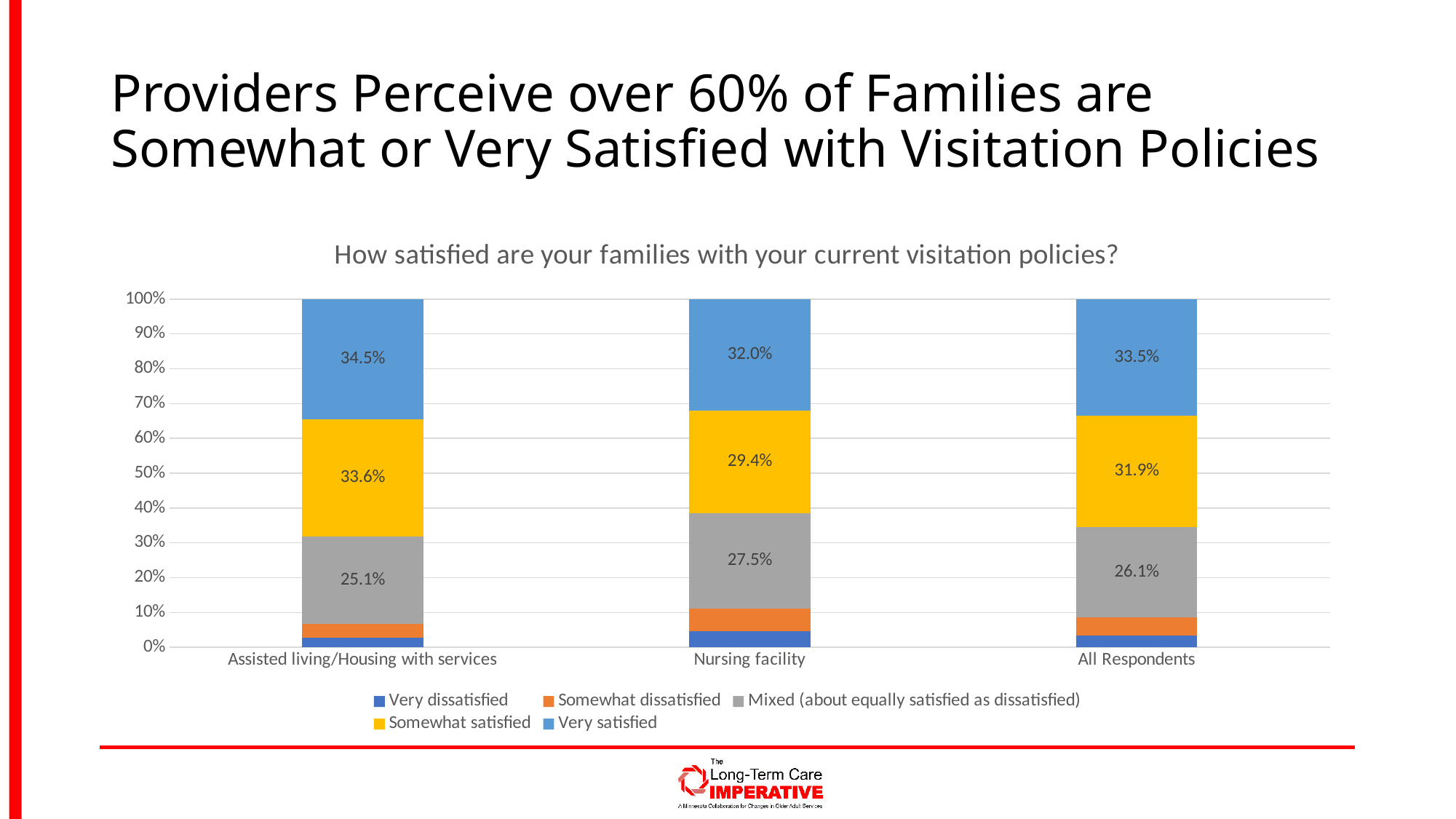
What kind of chart is shown on the slide? Stacked bar chart Which is larger: the Mixed value for Nursing facility or the Mixed value for All Respondents? Nursing facility What is the Mixed (about equally satisfied as dissatisfied) value for All Respondents? 26.1% What percentage of families are perceived as Very satisfied for Assisted living/Housing with services? 34.5% Is the Very dissatisfied value for Nursing facility greater or less than 10%? less How many series does the legend list? 5 Which category has the lowest Somewhat satisfied percentage? Nursing facility What is the Somewhat satisfied value for Nursing facility? 29.4% What is the difference between the Very satisfied values for Assisted living/Housing with services and Nursing facility? 2.5% What is the title of the chart? How satisfied are your families with your current visitation policies? How many categories are shown on the x axis? 3 Which category has the highest Very satisfied percentage? Assisted living/Housing with services